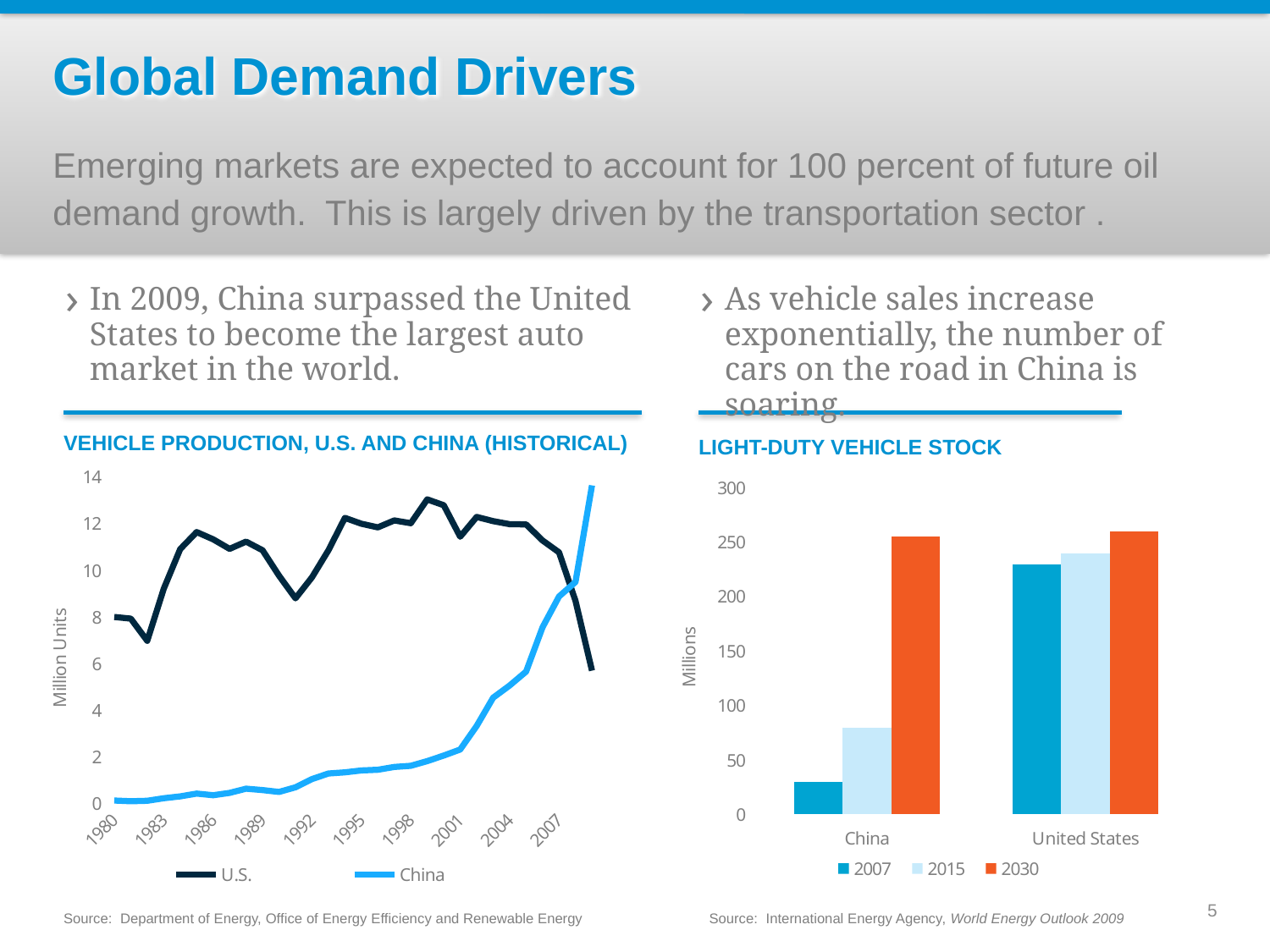
In the 'VEHICLE PRODUCTION, U.S. AND CHINA (HISTORICAL)' chart, is the U.S. value in 1980 greater or less than 6? greater In the 'VEHICLE PRODUCTION, U.S. AND CHINA (HISTORICAL)' chart, which series is higher in 1980, U.S. or China? U.S. In the 'LIGHT-DUTY VEHICLE STOCK' chart, is the 2007 value for China greater or less than 50? less What kind of chart is the 'LIGHT-DUTY VEHICLE STOCK' chart? bar chart How many series does the legend of the 'LIGHT-DUTY VEHICLE STOCK' chart list? 3 What kind of chart is the 'VEHICLE PRODUCTION, U.S. AND CHINA (HISTORICAL)' chart? line chart How many categories are shown on the x axis of the 'LIGHT-DUTY VEHICLE STOCK' chart? 2 In the 'LIGHT-DUTY VEHICLE STOCK' chart, is the 2007 value for the United States greater or less than 200? greater In the 'LIGHT-DUTY VEHICLE STOCK' chart, which is larger for 2007, China or the United States? United States In the 'VEHICLE PRODUCTION, U.S. AND CHINA (HISTORICAL)' chart, does the China series rise or fall over the years shown? rise How many series does the legend of the 'VEHICLE PRODUCTION, U.S. AND CHINA (HISTORICAL)' chart list? 2